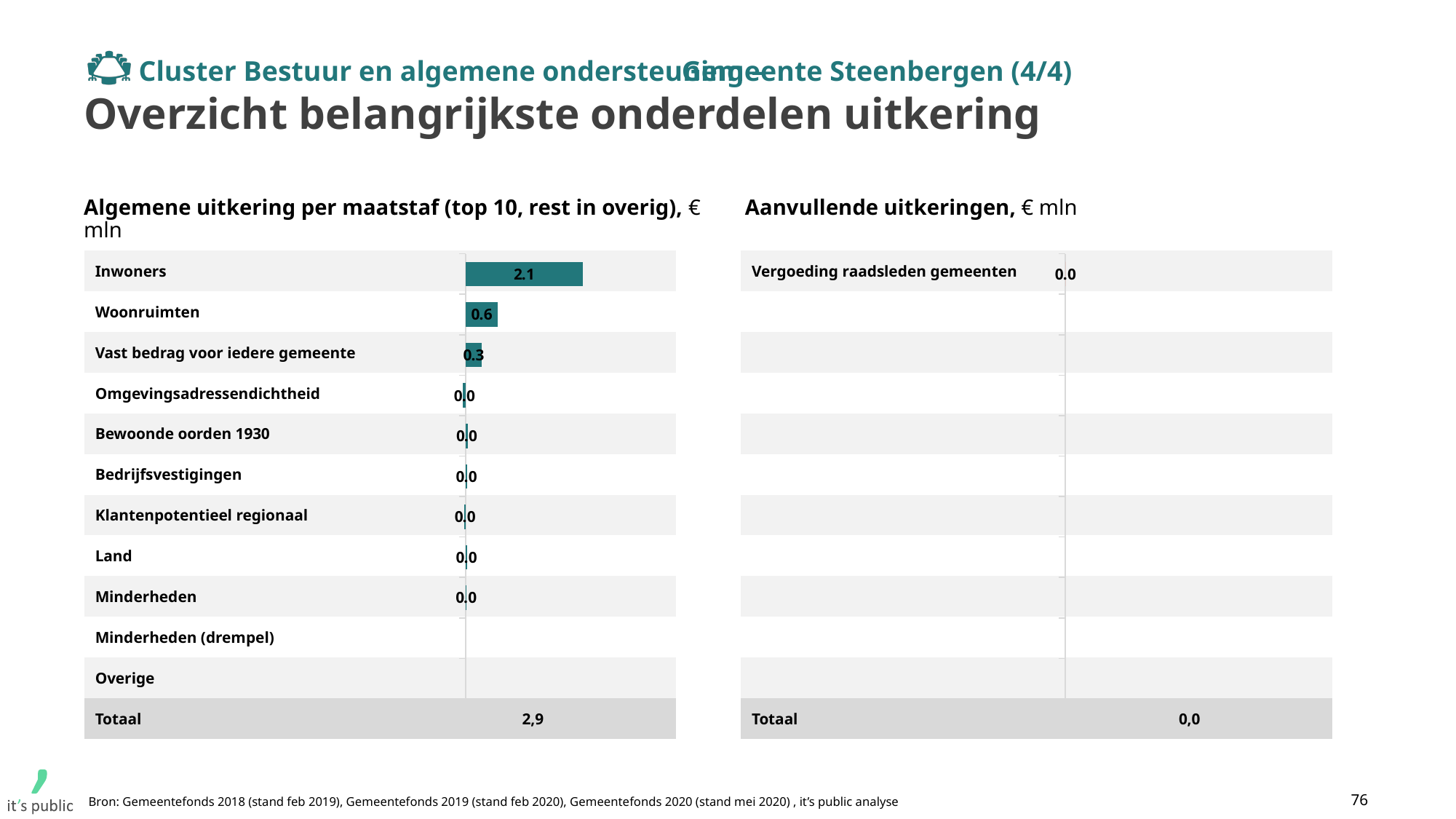
In the chart 'Algemene uitkering per maatstaf (top 10, rest in overig)', what is the Totaal value shown? 2,9 In the chart 'Algemene uitkering per maatstaf (top 10, rest in overig)', what is the value for Inwoners? 2.1 What kind of chart is the left chart 'Algemene uitkering per maatstaf (top 10, rest in overig)'? bar chart In the chart 'Algemene uitkering per maatstaf (top 10, rest in overig)', which is larger: Woonruimten or Vast bedrag voor iedere gemeente? Woonruimten What unit is stated in the title of the right chart 'Aanvullende uitkeringen'? € mln In the chart 'Aanvullende uitkeringen', what is the Totaal value shown? 0,0 In the chart 'Algemene uitkering per maatstaf (top 10, rest in overig)', what is the value for Woonruimten? 0.6 In the chart 'Algemene uitkering per maatstaf (top 10, rest in overig)', what is the value for Vast bedrag voor iedere gemeente? 0.3 In the chart 'Algemene uitkering per maatstaf (top 10, rest in overig)', which category has the highest value? Inwoners In the chart 'Algemene uitkering per maatstaf (top 10, rest in overig)', how many categories are listed above the Totaal row? 11 In the chart 'Aanvullende uitkeringen', what is the value for Vergoeding raadsleden gemeenten? 0.0 In the chart 'Algemene uitkering per maatstaf (top 10, rest in overig)', what is the difference between the values for Inwoners and Woonruimten? 1.5